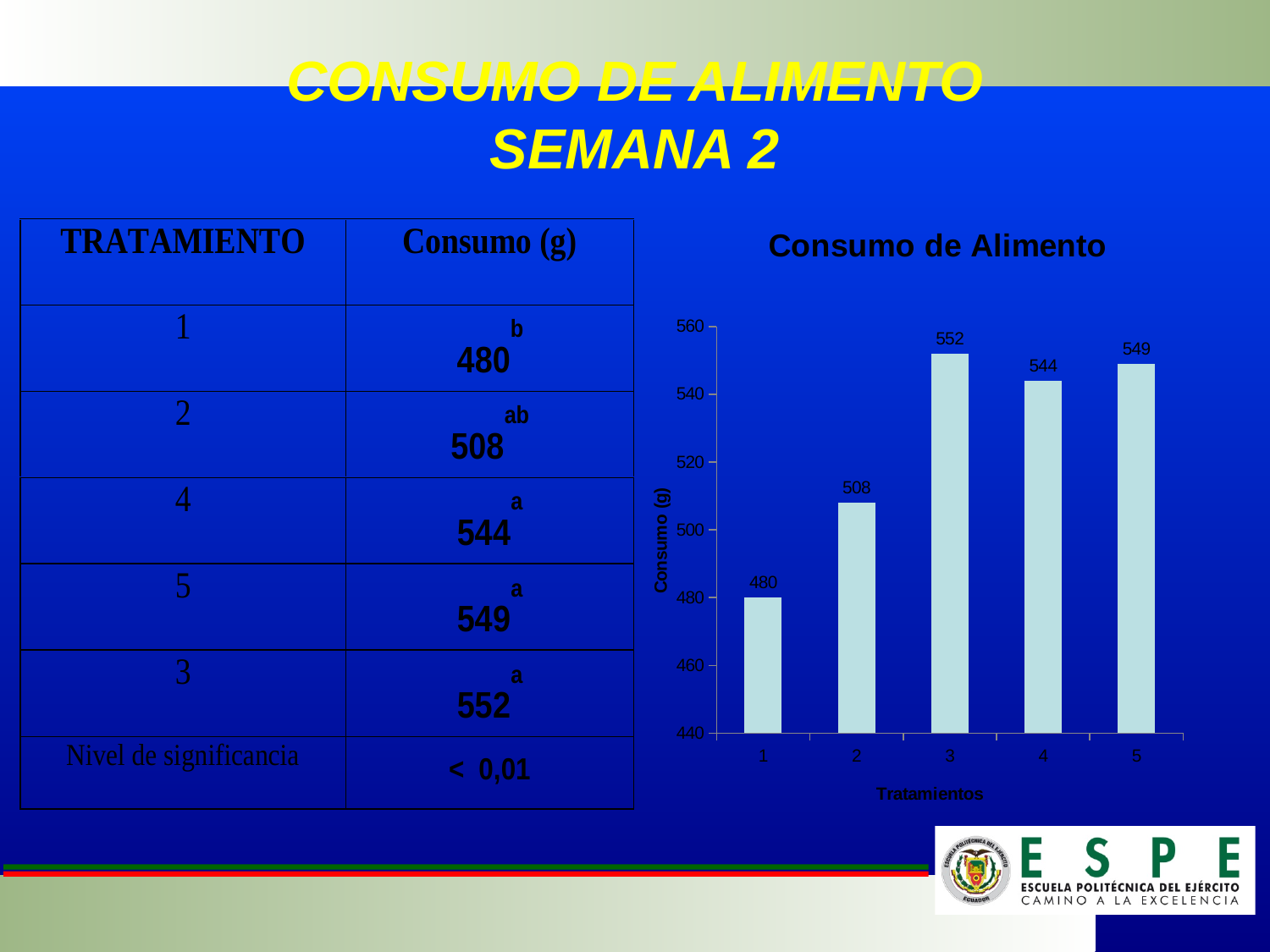
What is the value for Tratamiento 1 in the chart? 480 What is the value for Tratamiento 3 in the chart? 552 What is the difference between the values for Tratamiento 3 and Tratamiento 1? 72 What is the difference between the values for Tratamiento 5 and Tratamiento 4? 5 Is the value for Tratamiento 2 greater or less than 520? less What kind of chart is shown on the slide? bar chart What is the value for Tratamiento 4 in the chart? 544 What is the title of the chart? Consumo de Alimento Which is larger, the value for Tratamiento 2 or Tratamiento 4? Tratamiento 4 How many tratamientos are shown on the x axis of the chart? 5 Which tratamiento has the lowest consumo in the chart? 1 Which tratamiento has the highest consumo in the chart? 3